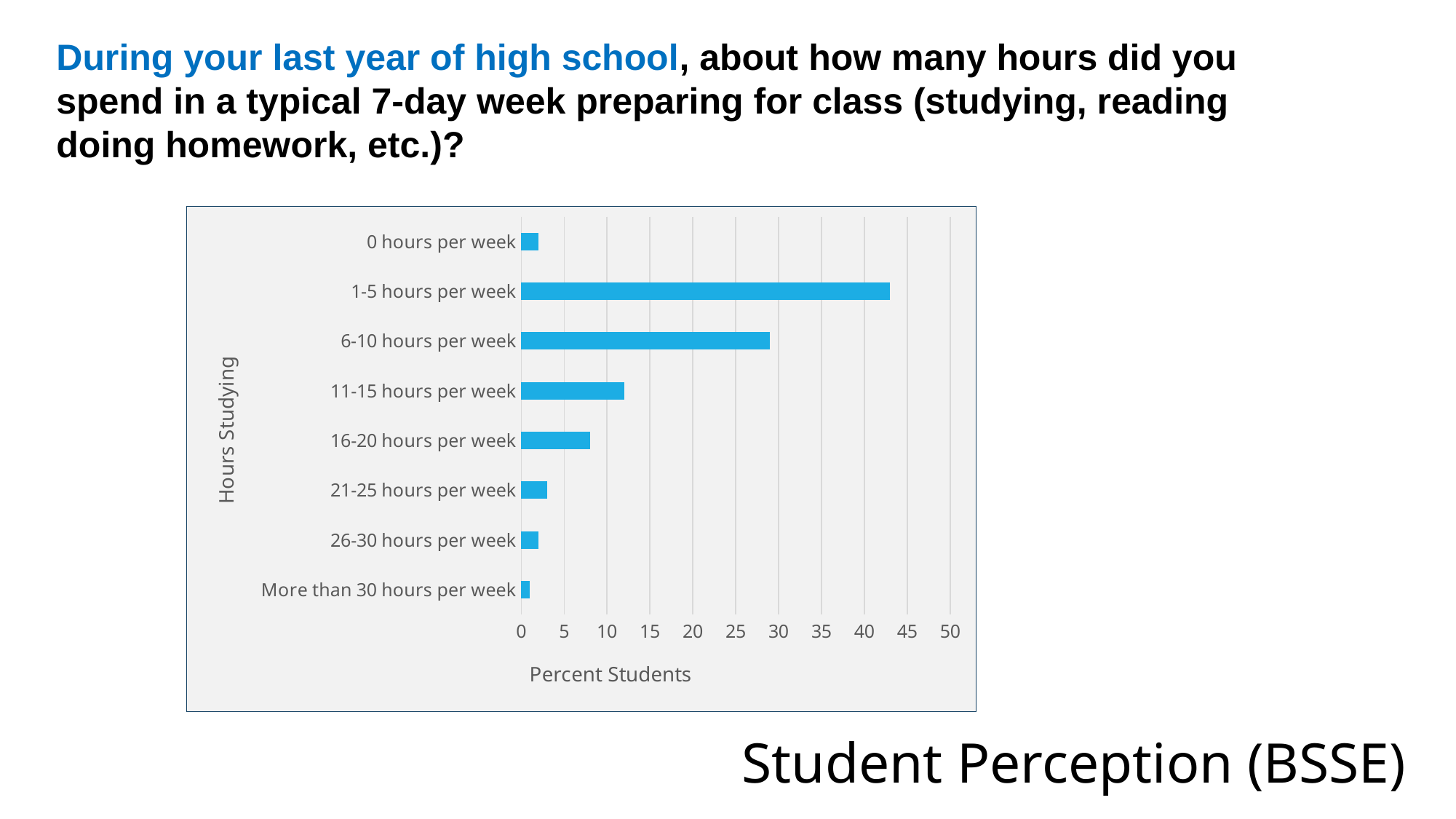
Which hours-studying category has the highest percent of students? 1-5 hours per week Is the value for 11-15 hours per week greater or less than 10? greater Is the value for 16-20 hours per week greater or less than 10? less Is the value for 21-25 hours per week greater or less than 5? less What is the title of the vertical axis of the chart? Hours Studying What type of chart is shown on the slide? bar chart How many hours-studying categories are plotted in the chart? 8 Which is larger, the value for 16-20 hours per week or the value for 21-25 hours per week? 16-20 hours per week Which is larger, the value for 6-10 hours per week or the value for 11-15 hours per week? 6-10 hours per week What is the title of the horizontal axis of the chart? Percent Students